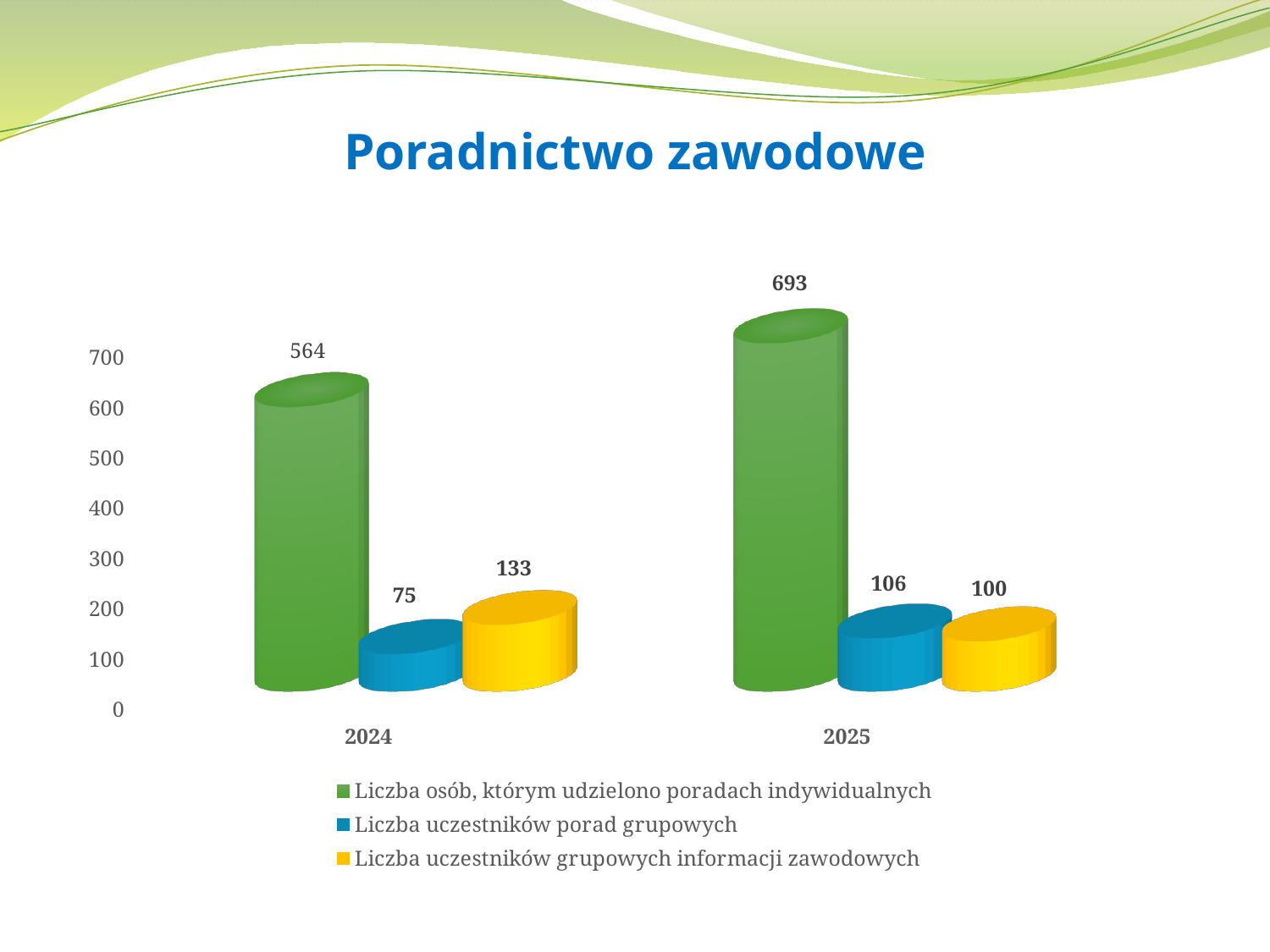
What is the value for "Liczba osób, którym udzielono poradach indywidualnych" in 2025? 693 What is the value for "Liczba uczestników porad grupowych" in 2024? 75 Which year has the higher value for "Liczba uczestników porad grupowych"? 2025 What is the difference between "Liczba uczestników grupowych informacji zawodowych" in 2024 and 2025? 33 What kind of chart is shown on the slide? Bar chart What is the title of the slide? Poradnictwo zawodowe Which series has the highest value in 2025? Liczba osób, którym udzielono poradach indywidualnych Which series has the lowest value in 2024? Liczba uczestników porad grupowych What is the value for "Liczba osób, którym udzielono poradach indywidualnych" in 2024? 564 What is the value for "Liczba uczestników grupowych informacji zawodowych" in 2025? 100 How many series does the legend list? 3 What is the difference between the 2025 and 2024 values for "Liczba osób, którym udzielono poradach indywidualnych"? 129